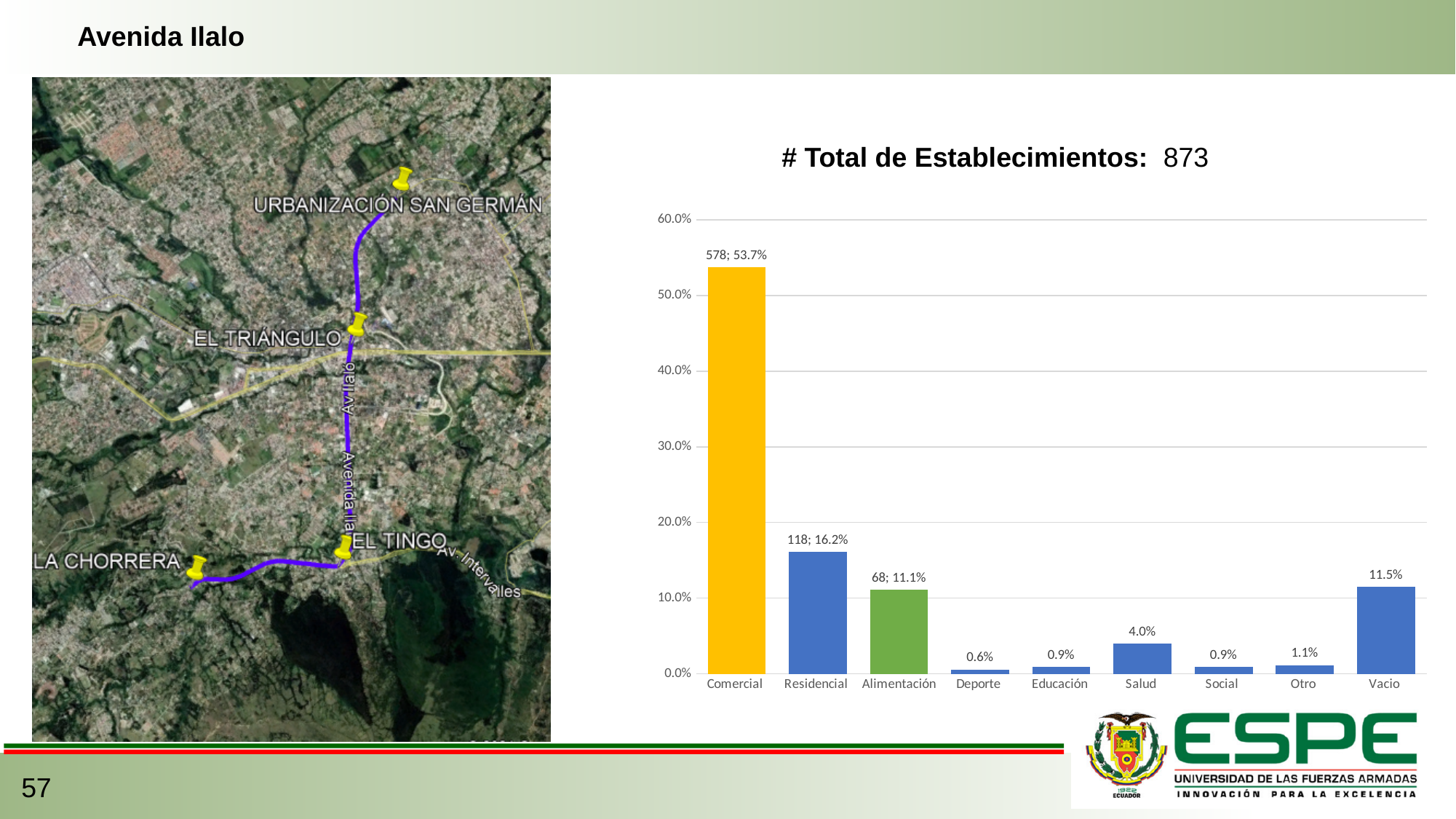
What percentage is shown for Vacio? 11.5% Is the value for Comercial greater or less than 50.0%? greater How many categories are shown on the x axis? 9 What percentage is shown for Comercial? 53.7% Which is larger, the value for Vacio or the value for Alimentación? Vacio Which category has the lowest value? Deporte What total number of establishments is stated in the chart title? 873 What percentage is shown for Salud? 4.0% Which category has the highest value? Comercial What kind of chart is shown on the slide? bar chart What is the difference in percentage points between Residencial and Alimentación? 5.1 What count is printed on the data label for Residencial? 118